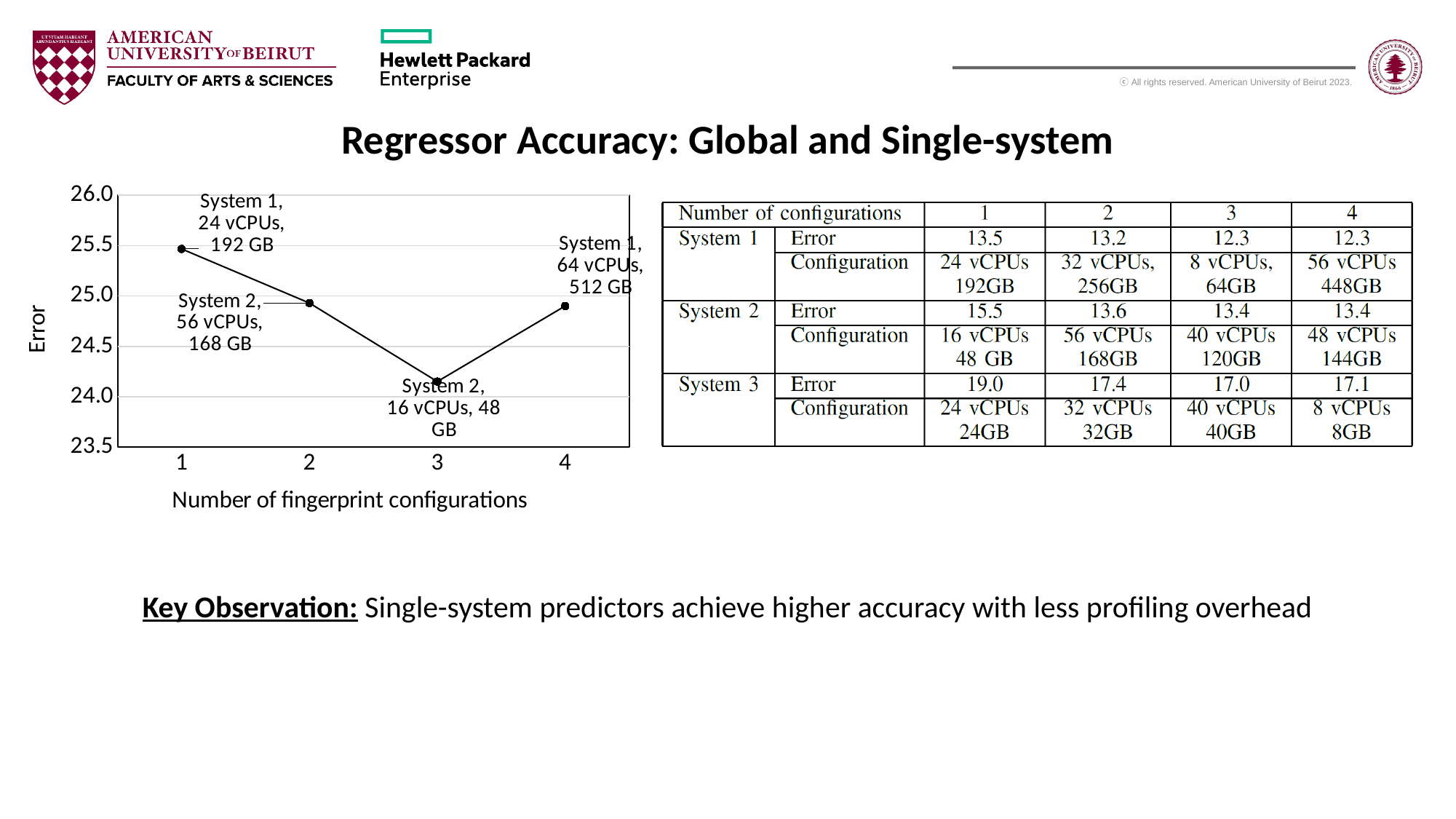
Which system and configuration is labeled at the point for 3 fingerprint configurations? System 2, 16 vCPUs, 48 GB What is the title of the x axis of the line chart? Number of fingerprint configurations How many data points are plotted on the line chart? 4 Is the error for 1 fingerprint configuration greater or less than 25.0? greater At which number of fingerprint configurations is the error lowest on the line chart? 3 Which has the higher error on the line chart: 1 fingerprint configuration or 3 fingerprint configurations? 1 fingerprint configuration At which number of fingerprint configurations is the error highest on the line chart? 1 Is the error for 3 fingerprint configurations greater or less than 24.0? greater Does the error rise or fall as the number of fingerprint configurations goes from 1 to 3? fall What kind of chart is shown on the slide? line chart Is the error for 3 fingerprint configurations greater or less than 24.5? less